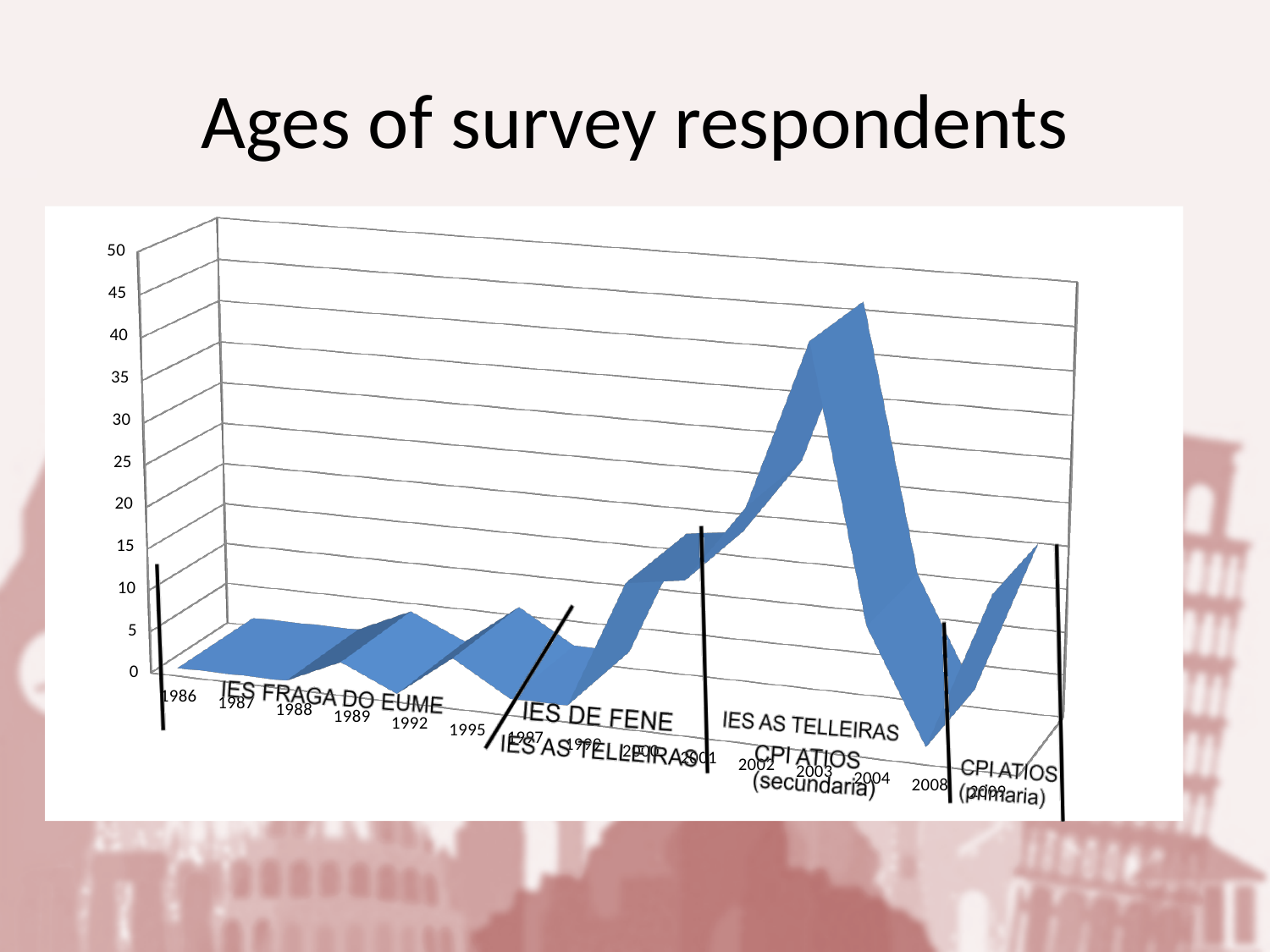
What kind of chart is shown on the slide? line chart How many years are labelled on the horizontal axis? 15 Does the value rise or fall between 2003 and 2008? fall Is the value for 2008 greater or less than 5? less What is the highest value shown on the vertical axis? 50 Is the value for 2003 greater or less than 30? greater Which is larger, the value for 2003 or the value for 1986? 2003 What is the title of the chart? Ages of survey respondents Is the value for 1986 greater or less than 10? less Which year has the highest value in the chart? 2003 Which is larger, the value for 2001 or the value for 1988? 2001 Does the value rise or fall between 1995 and 2003 overall? rise